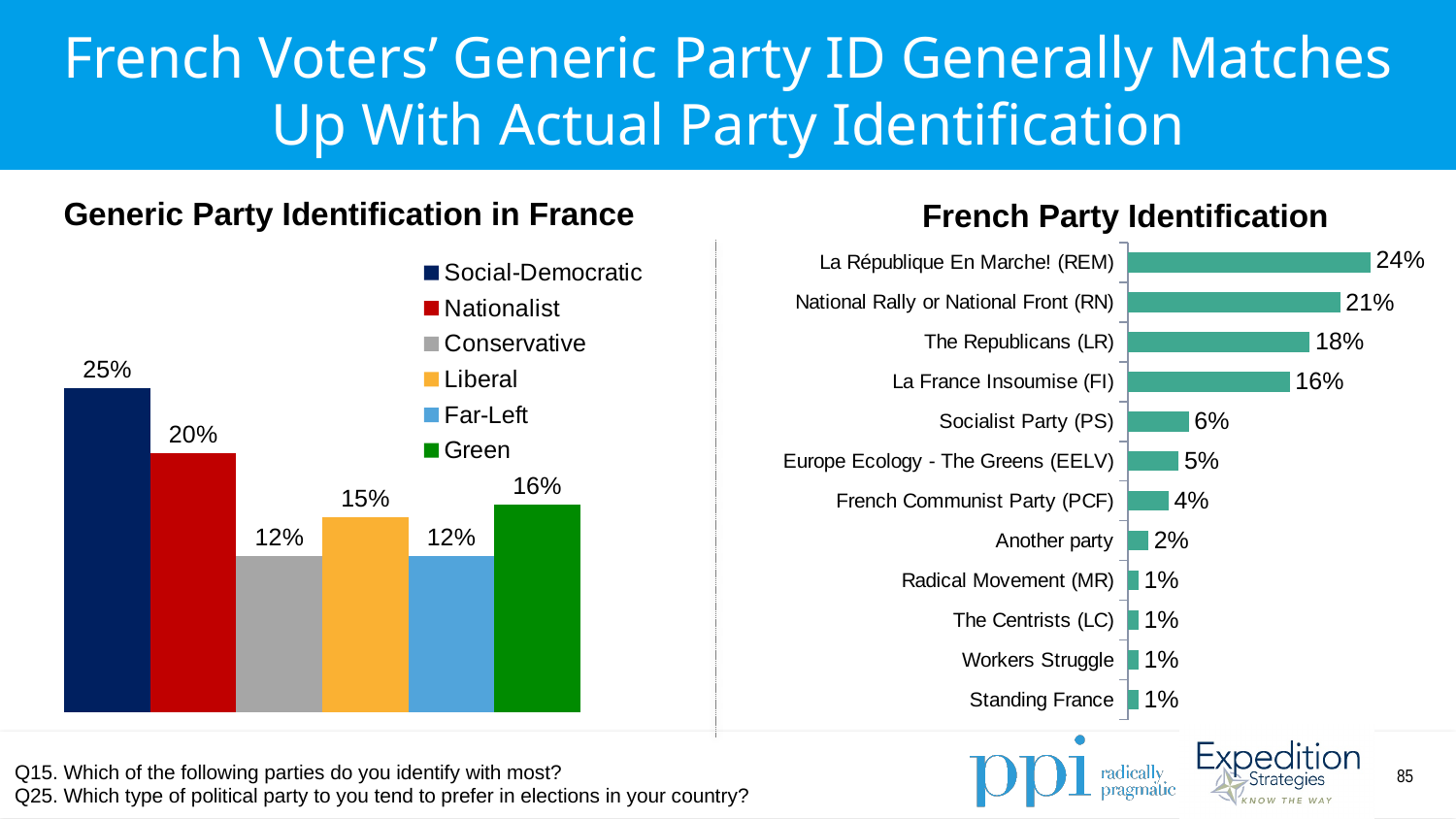
In the 'Generic Party Identification in France' chart, what is the difference between Nationalist and Green? 4% In the 'Generic Party Identification in France' chart, how many series does the legend list? 6 In the 'Generic Party Identification in France' chart, what is the value for Social-Democratic? 25% In the 'French Party Identification' chart, how many categories are shown? 12 In the 'French Party Identification' chart, what is the difference between La République En Marche! (REM) and National Rally or National Front (RN)? 3% In the 'Generic Party Identification in France' chart, what is the value for Liberal? 15% What kind of chart is the 'French Party Identification' chart? Bar chart In the 'Generic Party Identification in France' chart, which category has the highest value? Social-Democratic In the 'Generic Party Identification in France' chart, which is larger, Liberal or Far-Left? Liberal In the 'French Party Identification' chart, what is the value for The Republicans (LR)? 18% In the 'French Party Identification' chart, which party has the highest value? La République En Marche! (REM) In the 'French Party Identification' chart, what is the value for Socialist Party (PS)? 6%